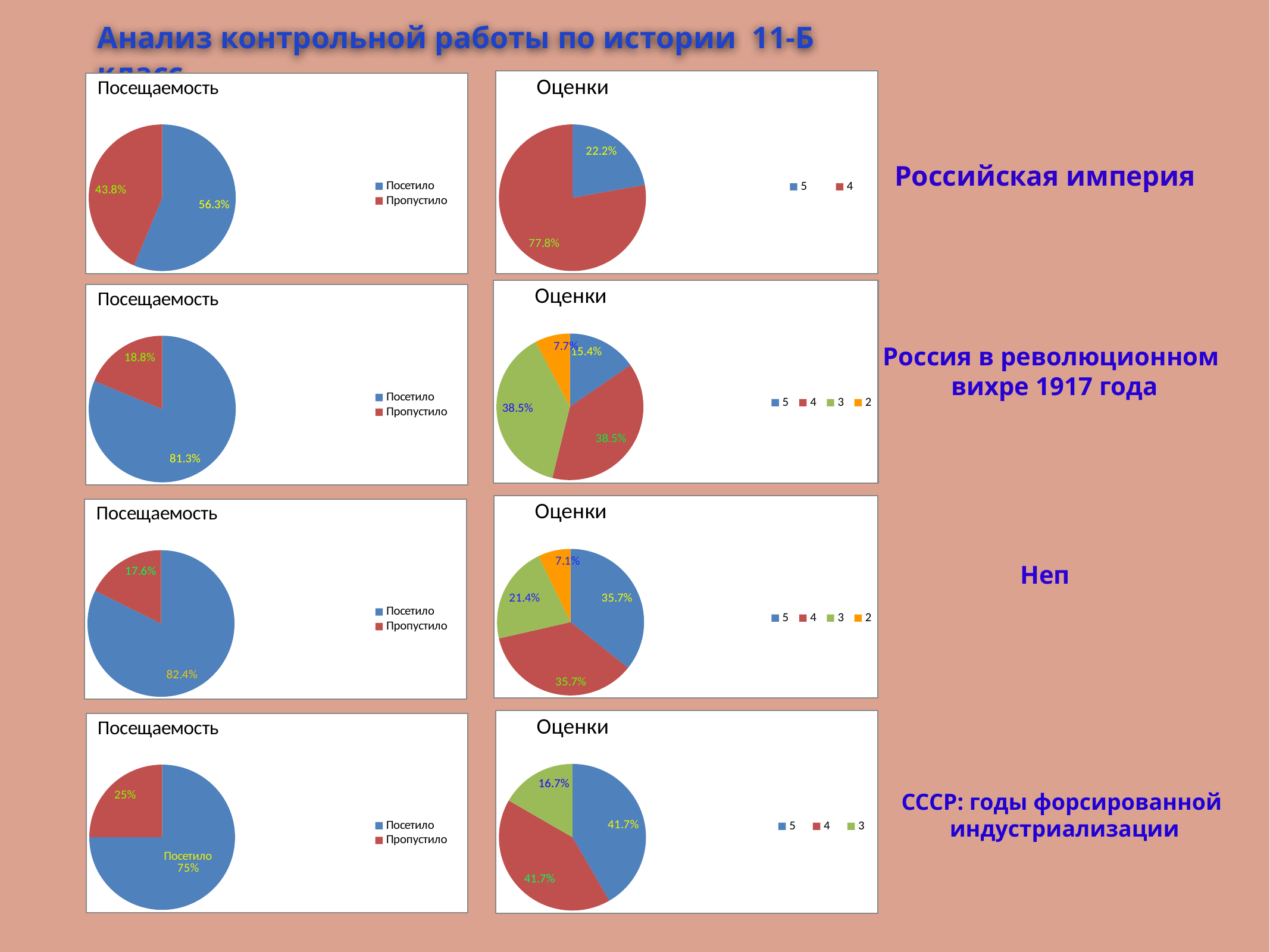
In the third-row 'Посещаемость' pie chart (Неп row), which category is larger, 'Посетило' or 'Пропустило'? Посетило In the bottom-row 'Посещаемость' pie chart (СССР row), what share is labelled for 'Пропустило'? 25% In the bottom-row 'Оценки' pie chart (СССР row), how many grade categories does the legend list? 3 How many pie charts are shown on the slide in total? 8 In the top-row 'Посещаемость' pie chart (Российская империя row), what share is labelled for 'Посетило'? 56.3% In the third-row 'Оценки' pie chart (Неп row), what is the difference between the share for grade 5 and the share for grade 2? 28.6% In the third-row 'Оценки' pie chart (Неп row), what share is labelled for grade 3? 21.4% What type of chart is used for the 'Оценки' charts on the slide? Pie chart In the second-row 'Оценки' pie chart (Россия в революционном вихре 1917 года row), which grade has the smallest share? 2 In the second-row 'Посещаемость' pie chart (Россия в революционном вихре 1917 года row), what share is labelled for 'Пропустило'? 18.8% In the second-row 'Оценки' pie chart (Россия в революционном вихре 1917 года row), how many grade categories does the legend list? 4 In the top-row 'Оценки' pie chart (Российская империя row), what share is labelled for grade 4? 77.8%